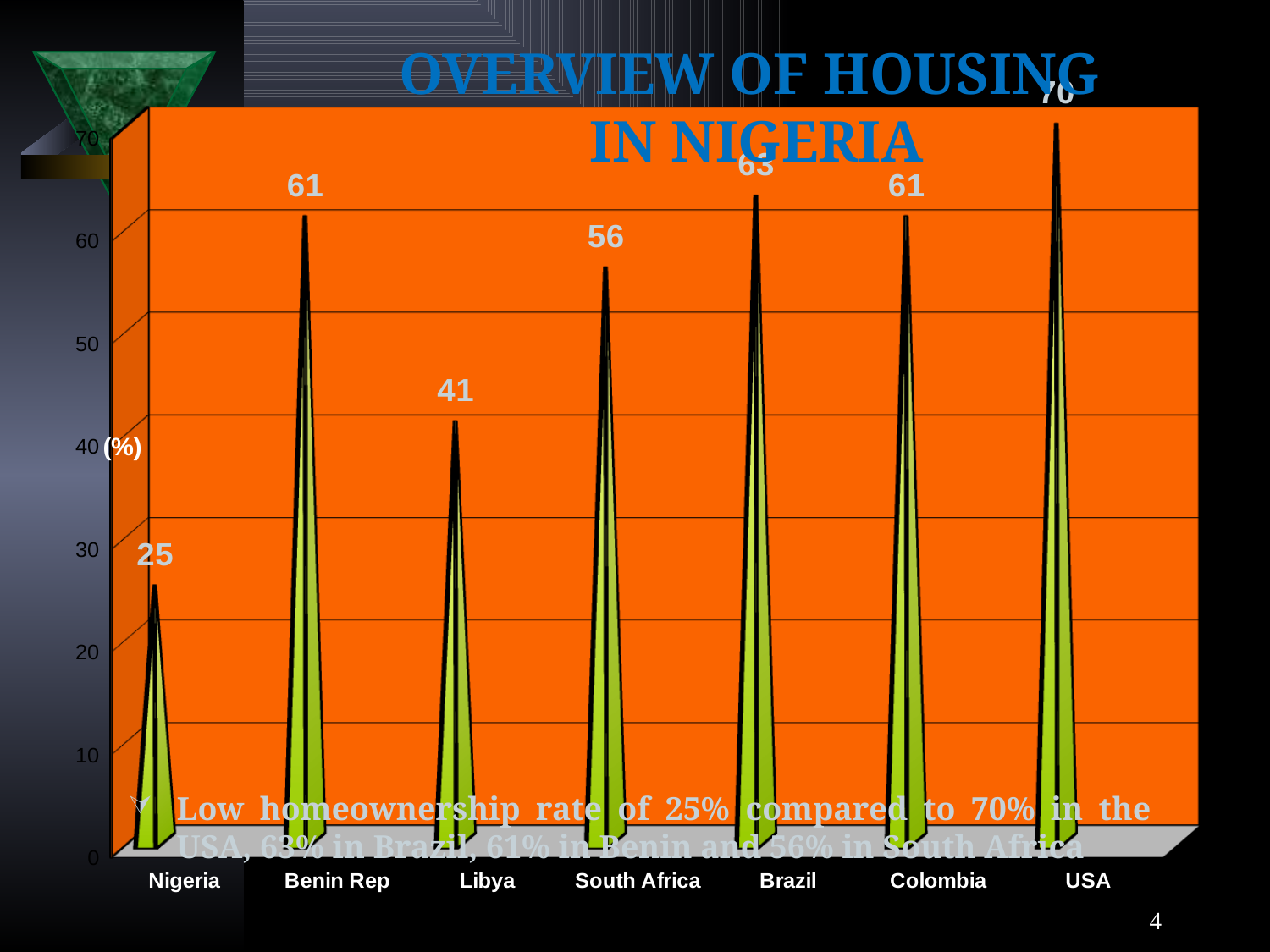
What is the value for Libya? 41 What is the difference between the values for Benin Rep and Nigeria? 36 Which country has the highest value? USA Which country has the lowest value? Nigeria What is the value for South Africa? 56 How many countries are shown on the x axis? 7 What unit is shown on the y axis label? (%) What is the value for Benin Rep? 61 What is the value for Nigeria? 25 Is the value for Brazil greater or less than 60? greater What is the value for Colombia? 61 Which is larger, the value for Libya or the value for South Africa? South Africa